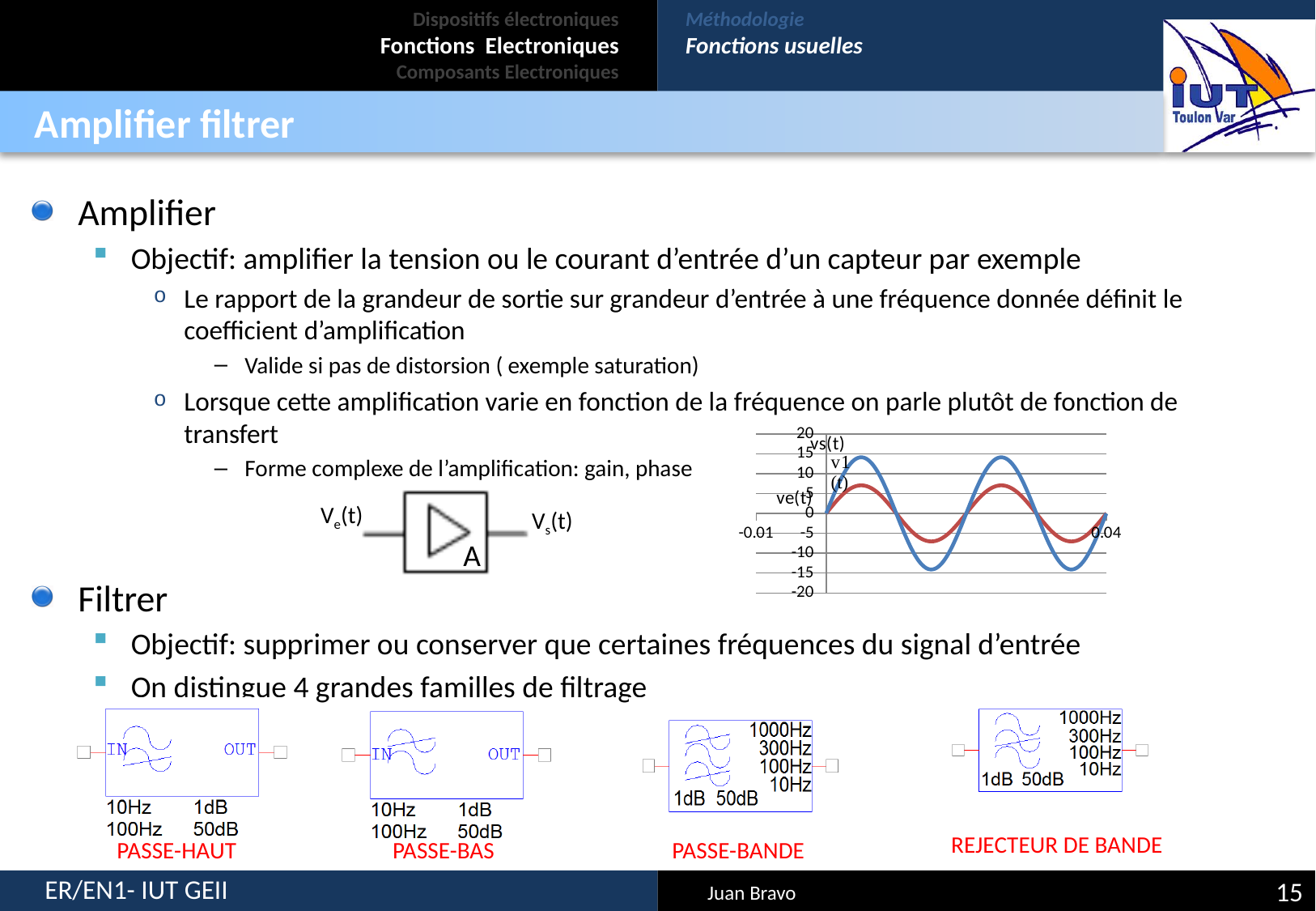
Which curve has the larger amplitude, vs(t) or ve(t)? vs(t) What is the lowest value shown on the vertical axis of the chart? -20 Is the peak value of the ve(t) curve greater or less than 10? less Is the minimum value of the vs(t) curve greater or less than -10? less What kind of chart is shown on the slide? line chart What is the rightmost value shown on the horizontal axis of the chart? 0.04 Is the peak value of the vs(t) curve greater or less than 10? greater What is the leftmost value shown on the horizontal axis of the chart? -0.01 What is the highest value shown on the vertical axis of the chart? 20 How many curves are plotted on the chart? 2